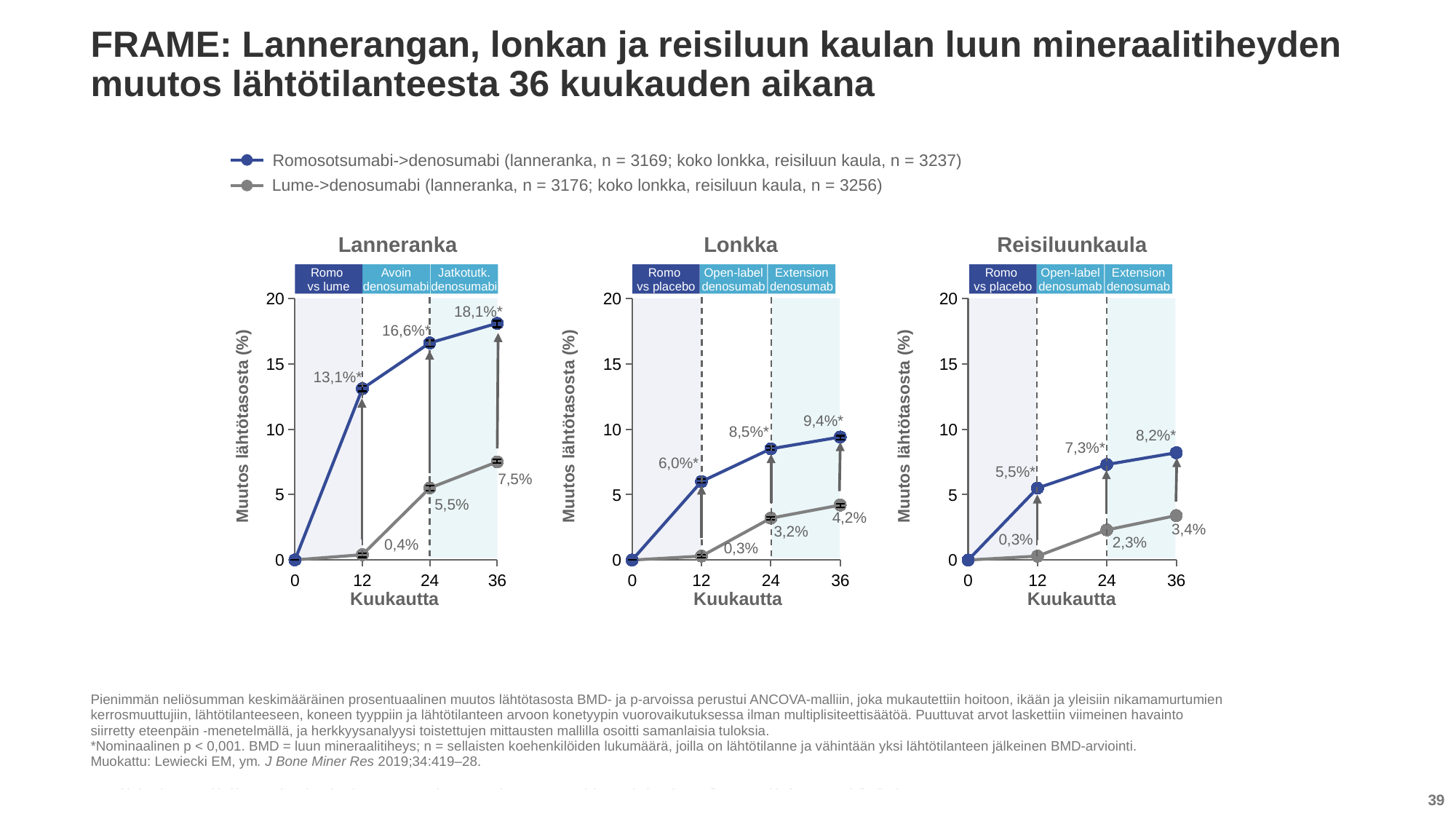
In the Reisiluunkaula chart, do the values for Lume->denosumabi rise or fall from 0 to 36 months? Rise What kind of chart is the Lonkka chart? Line chart In the Lanneranka chart, what is the value for Romosotsumabi->denosumabi at 36 months? 18,1%* How many charts are shown on the slide? 3 In the Lonkka chart, which series has the higher value at 24 months? Romosotsumabi->denosumabi In the Lanneranka chart, what is the value for Lume->denosumabi at 24 months? 5,5% In the Lonkka chart, what is the value for Romosotsumabi->denosumabi at 12 months? 6,0%* How many series does the legend list? 2 In the Reisiluunkaula chart, is the value for Romosotsumabi->denosumabi at 36 months greater or less than 10? less In the Lanneranka chart, is the value for Romosotsumabi->denosumabi at 24 months greater or less than 15? greater In the Reisiluunkaula chart, what is the value for Lume->denosumabi at 36 months? 3,4% In the Lanneranka chart, what is the difference between the two series at 36 months (18,1% vs 7,5%)? 10,6 percentage points